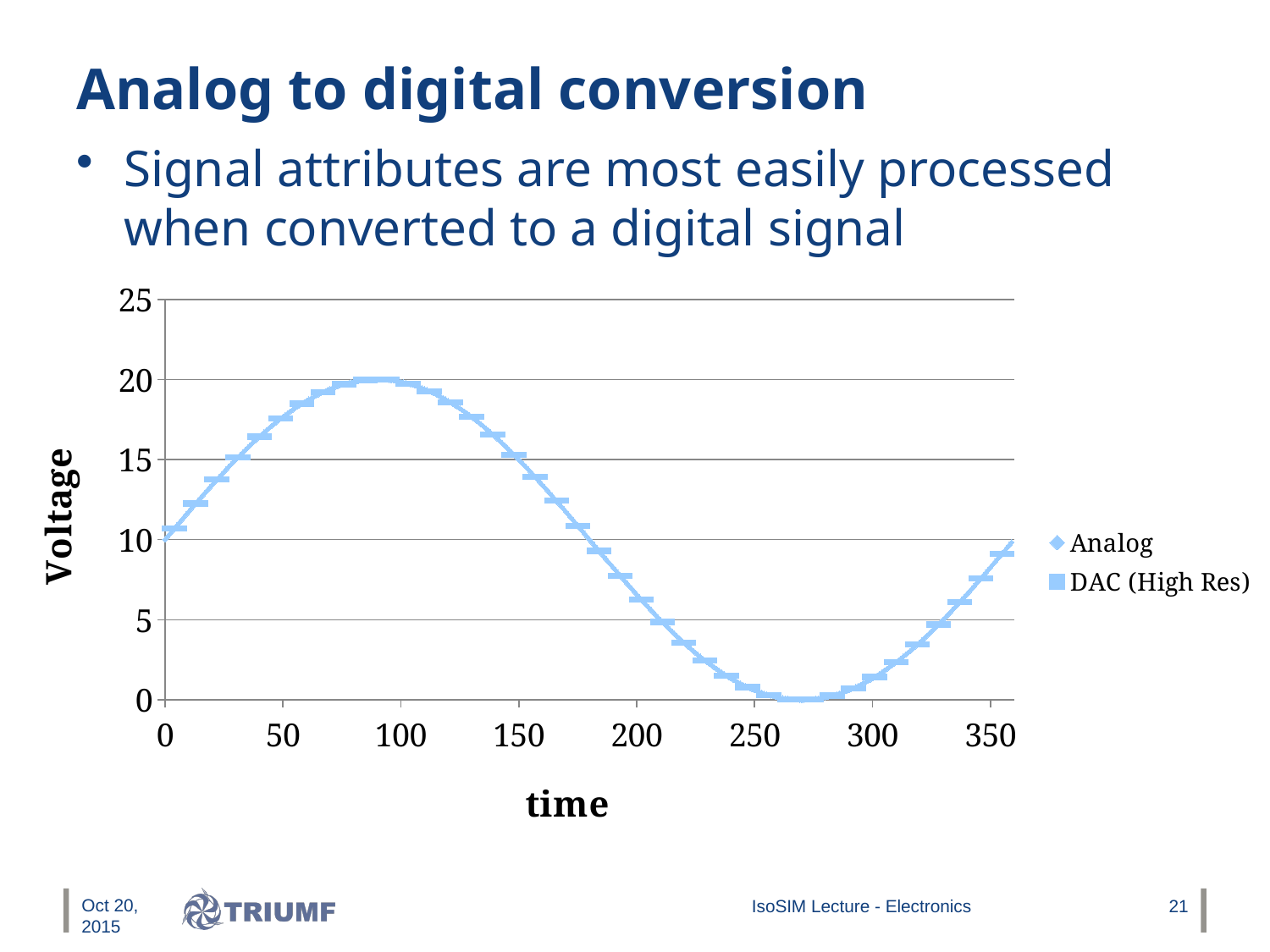
What are the two series named in the chart legend? Analog and DAC (High Res) Is the Voltage value at time 50 greater or less than 15? greater Is the Voltage value at time 100 greater or less than 15? greater Is the Voltage value at time 200 greater or less than 5? greater Between time 0 and time 90, do the Voltage values rise or fall? rise Between time 100 and time 250, do the Voltage values rise or fall? fall How many series does the chart legend list? 2 What kind of chart is shown on the slide? Scatter (line) chart What is the title of the vertical axis of the chart? Voltage Which is larger, the Voltage at time 100 or the Voltage at time 250? time 100